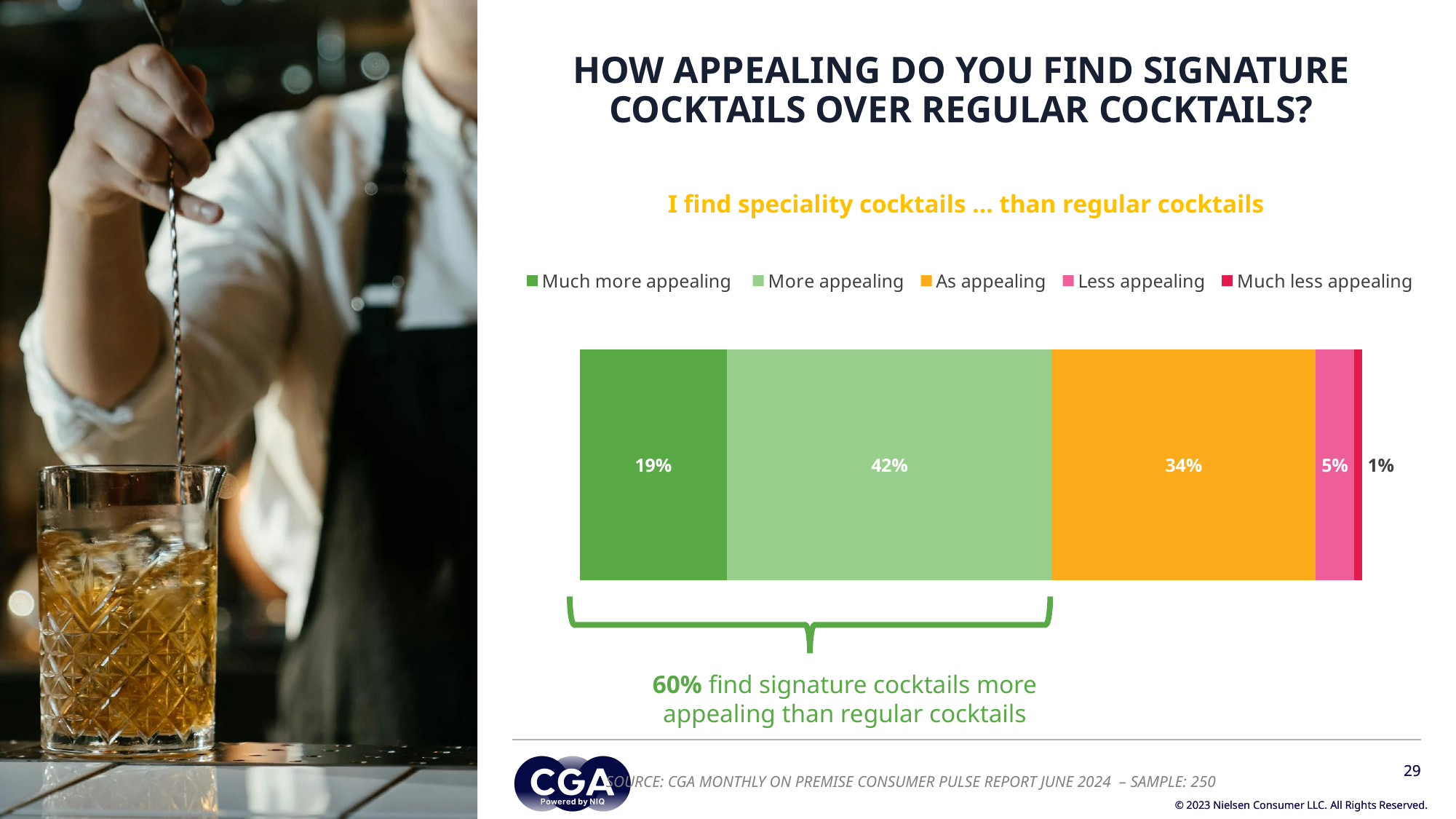
What percentage of respondents find speciality cocktails much more appealing than regular cocktails? 19% How many series does the legend list? 5 What is the difference in percentage points between 'More appealing' and 'As appealing'? 8 What percentage of respondents find speciality cocktails much less appealing than regular cocktails? 1% Which response category has the smallest share? Much less appealing What kind of chart is shown on the slide? Stacked bar chart What percentage of respondents find speciality cocktails more appealing than regular cocktails? 42% What percentage of respondents find speciality cocktails as appealing as regular cocktails? 34% What percentage of respondents find speciality cocktails less appealing than regular cocktails? 5% Which is larger: the share for 'Much more appealing' or the share for 'As appealing'? As appealing What is the combined share of 'Much more appealing' and 'More appealing'? 61% Which response category has the largest share? More appealing